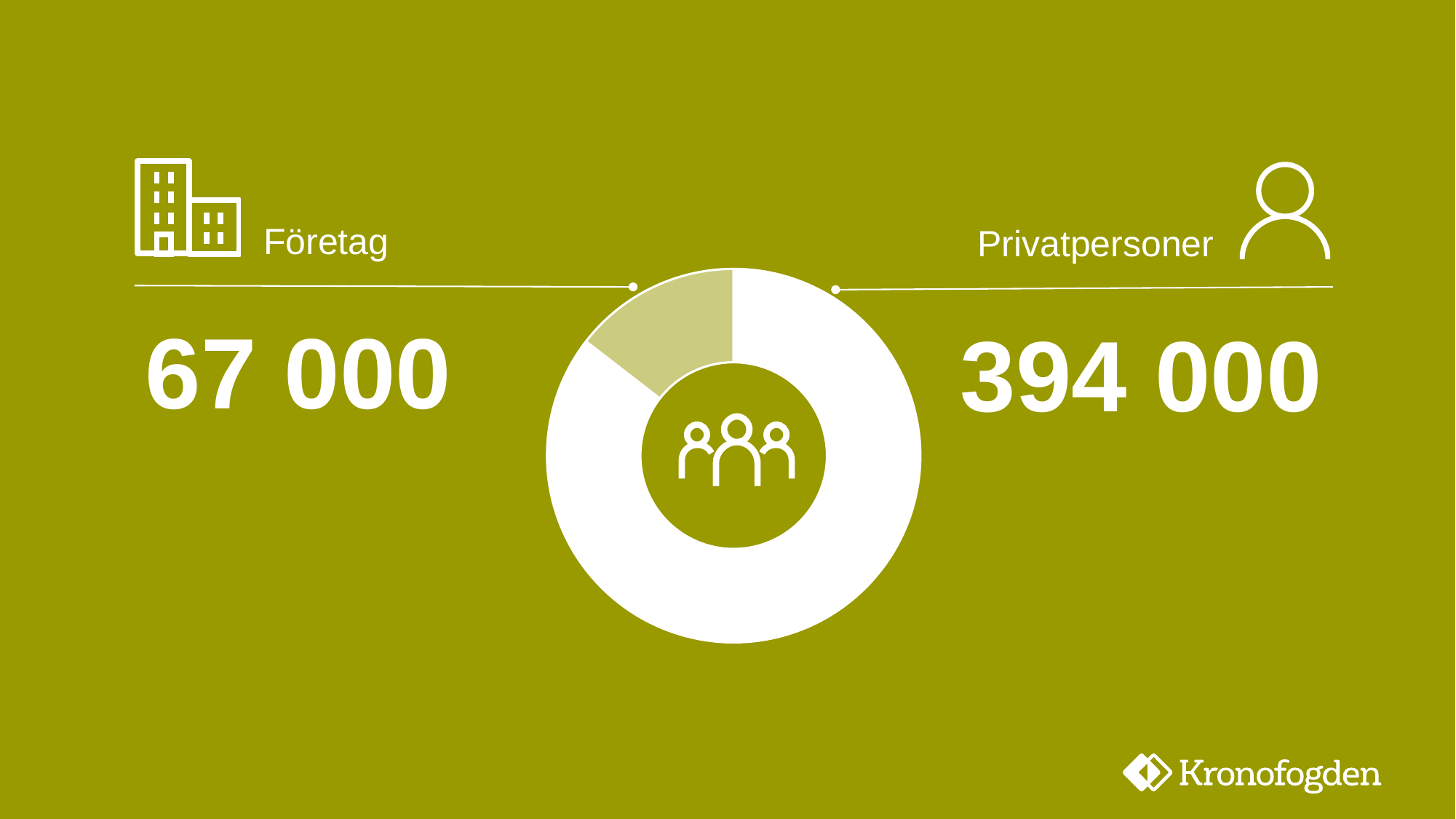
Which category is shown in the pale green segment of the chart? Företag What kind of chart is shown on the slide? Pie (donut) chart What is the total of the two values shown in the chart? 461 000 What is the value for Privatpersoner? 394 000 Which category has the lowest value? Företag How many categories does the chart show? 2 Which category has the highest value? Privatpersoner What is the difference between the values for Privatpersoner and Företag? 327 000 What is the value for Företag? 67 000 Which category is shown in white in the chart? Privatpersoner Which is larger, the value for Företag or the value for Privatpersoner? Privatpersoner